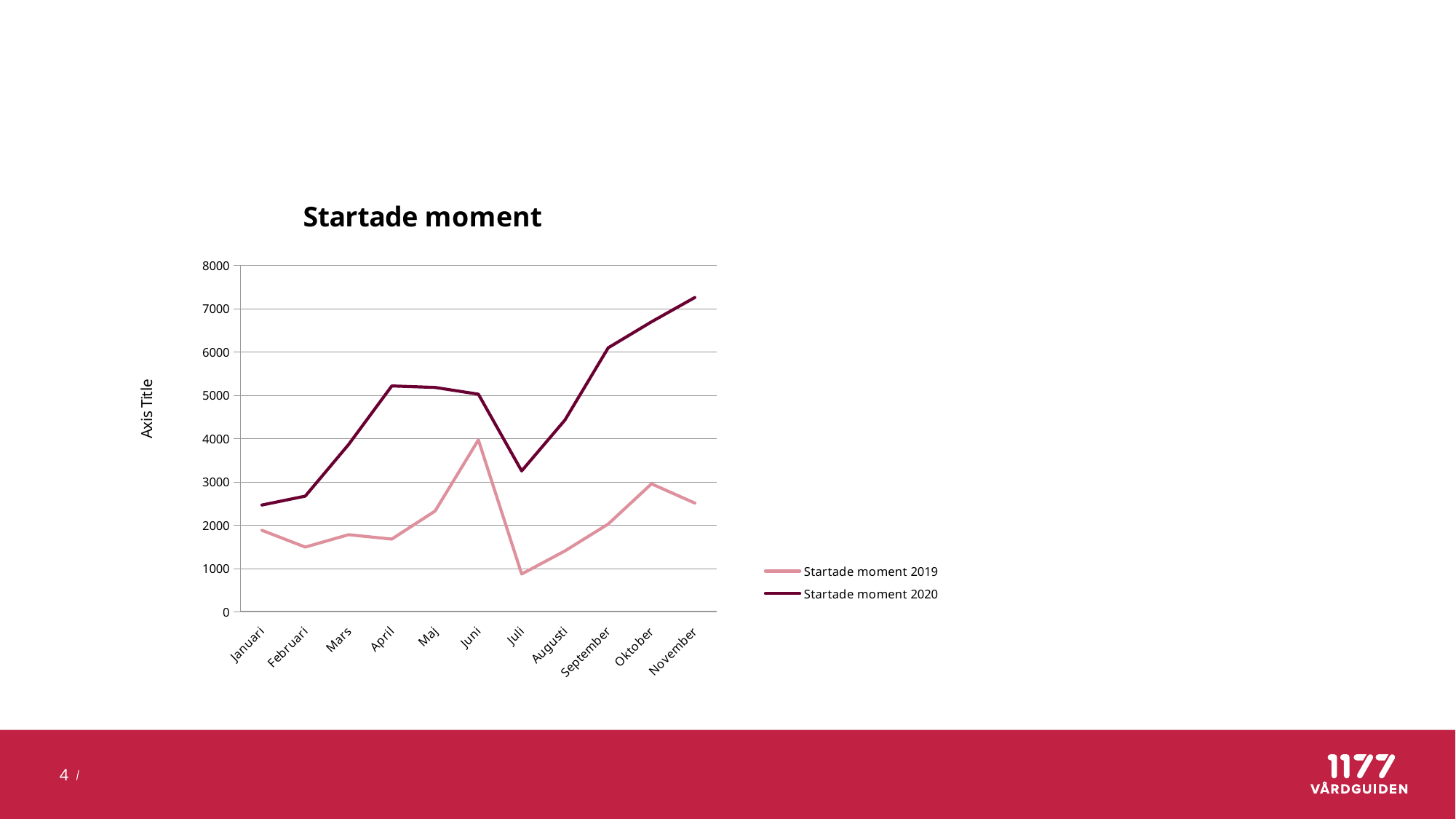
How many months are shown on the x axis? 11 In which month does the Startade moment 2019 series have its lowest value? Juli How many series does the legend list? 2 In which month does the Startade moment 2020 series reach its highest value? November Is the value for Startade moment 2020 in November greater or less than 7000? greater What is the title of the chart? Startade moment In which month does the Startade moment 2019 series reach its highest value? Juni Is the value for Startade moment 2019 in Juli greater or less than 1000? less Does the Startade moment 2020 series rise or fall from Juli to November? rise In which month does the Startade moment 2020 series have its lowest value? Januari What kind of chart is shown on the slide? line chart Which series has the larger value in Juni, Startade moment 2019 or Startade moment 2020? Startade moment 2020